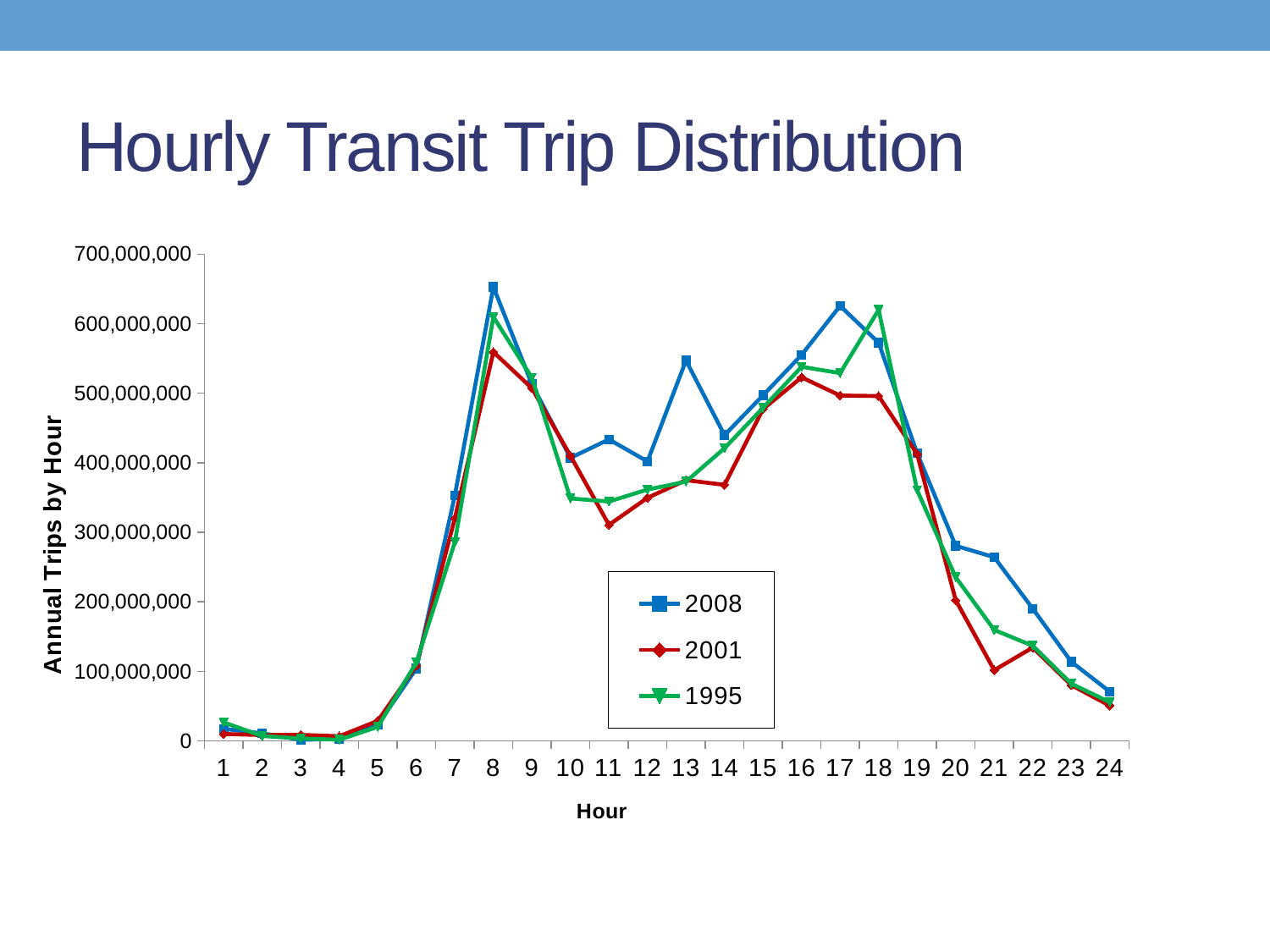
How many hours are plotted along the x axis? 24 How many series does the legend list? 3 At which hour does the 2008 series reach its highest value? 8 Is the value for 2008 at hour 24 greater or less than 100,000,000? less At hour 13, which series has the larger value, 2008 or 2001? 2008 At which hour does the 2001 series reach its highest value? 8 Is the value for 2008 at hour 13 greater or less than 500,000,000? greater What kind of chart is shown on the slide? line chart Is the value for 2008 at hour 21 greater or less than 200,000,000? greater At hour 18, which series has the larger value, 1995 or 2001? 1995 Do the values for the 2008 series rise or fall from hour 18 to hour 24? fall